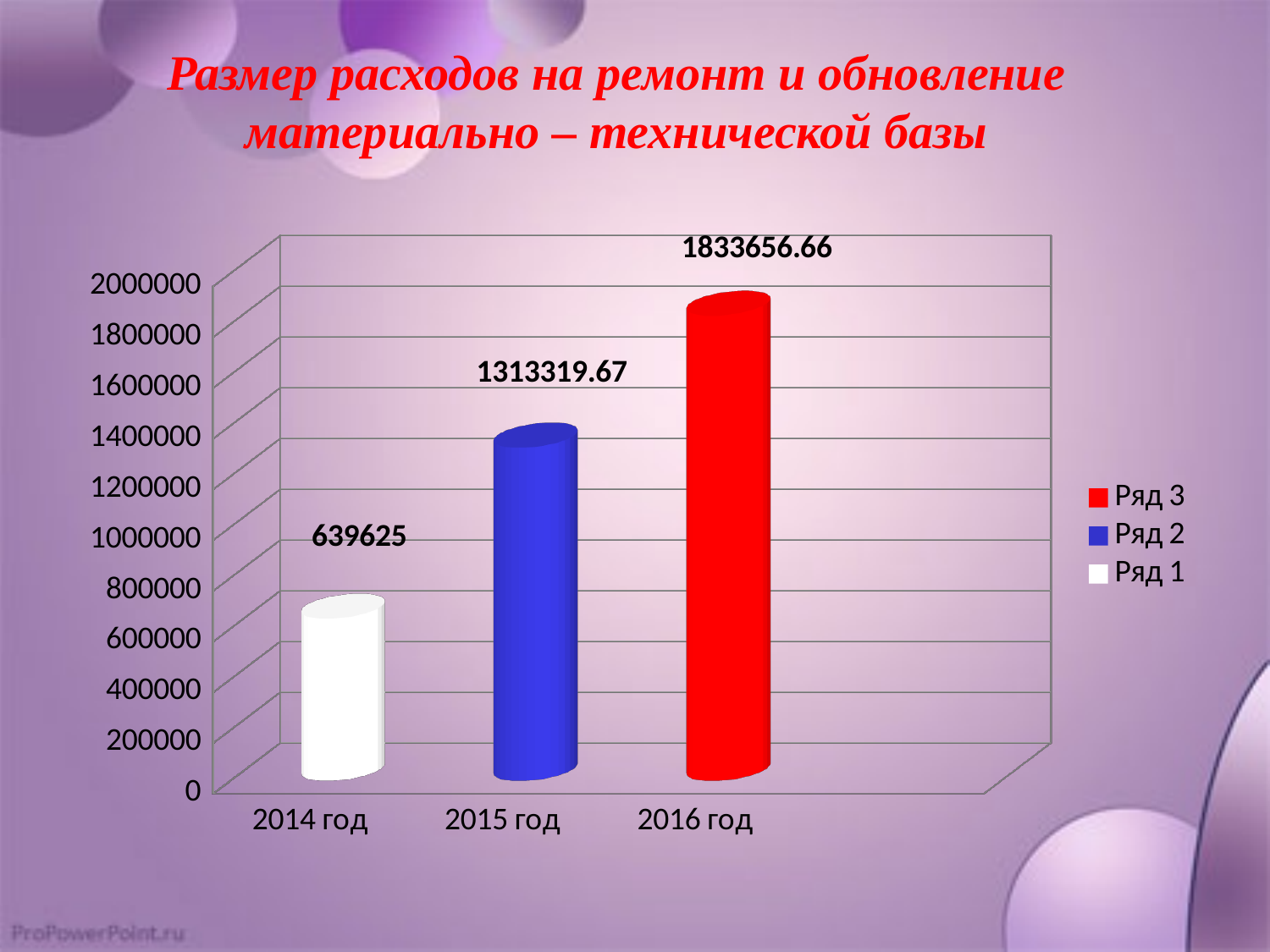
How many years are shown on the x axis? 3 What is the value shown for 2014 год? 639625 Is the value for 2016 год greater or less than 1600000? greater What is the difference between the values for 2015 год and 2014 год? 673694.67 What is the value shown for 2015 год? 1313319.67 Which is larger, the value for 2015 год or the value for 2014 год? 2015 год What is the value shown for 2016 год? 1833656.66 Do the values rise or fall from 2014 год to 2016 год? rise What kind of chart is shown on the slide? bar chart Which year has the highest value? 2016 год What is the difference between the values for 2016 год and 2015 год? 520336.99 Which year has the lowest value? 2014 год